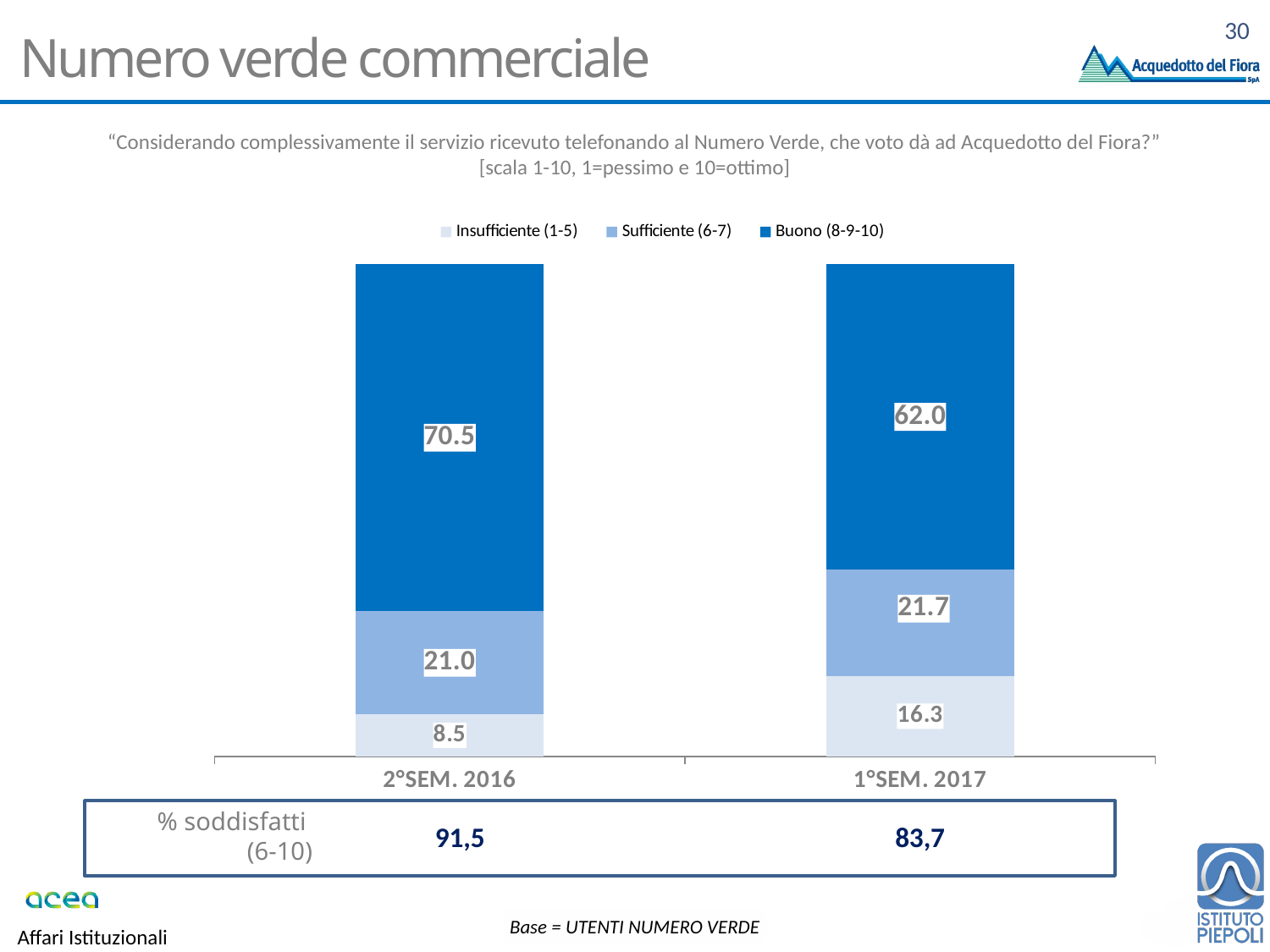
How many periods (categories) are shown on the x axis? 2 What kind of chart is shown on the slide? Stacked bar chart What is the value for Buono (8-9-10) in 2°SEM. 2016? 70.5 Which period has the higher value for Buono (8-9-10)? 2°SEM. 2016 What is the value for Insufficiente (1-5) in 1°SEM. 2017? 16.3 Is the Insufficiente (1-5) value larger in 2°SEM. 2016 or in 1°SEM. 2017? 1°SEM. 2017 What is the total of the stacked bar for 1°SEM. 2017? 100.0 Which period has the lower value for Insufficiente (1-5)? 2°SEM. 2016 How many series does the legend list? 3 What is the value for Sufficiente (6-7) in 1°SEM. 2017? 21.7 What is the difference between the Buono (8-9-10) values for 2°SEM. 2016 and 1°SEM. 2017? 8.5 What is the value for Sufficiente (6-7) in 2°SEM. 2016? 21.0